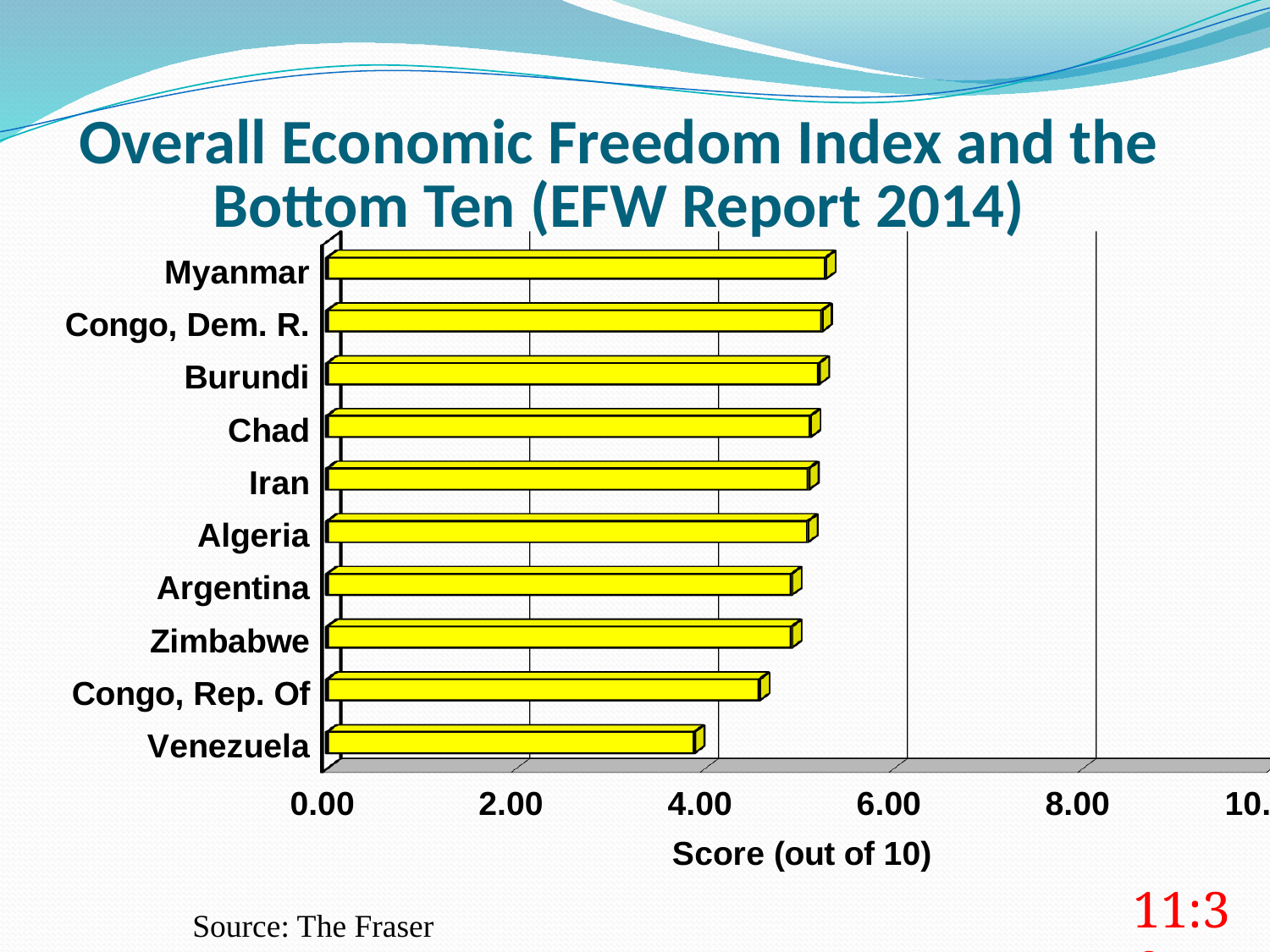
What is the label of the horizontal axis? Score (out of 10) Which has the higher score, Congo, Rep. Of or Zimbabwe? Zimbabwe What kind of chart is shown on the slide? bar chart Which has the higher score, Venezuela or Congo, Rep. Of? Congo, Rep. Of Which country has the lowest score in the chart? Venezuela Is the score for Burundi greater or less than 6.00? less Which has the higher score, Venezuela or Myanmar? Myanmar What is the title of the slide containing the chart? Overall Economic Freedom Index and the Bottom Ten (EFW Report 2014) How many countries are plotted in the chart? 10 Is the score for Myanmar greater or less than 4.00? greater Is the score for Congo, Rep. Of greater or less than 6.00? less